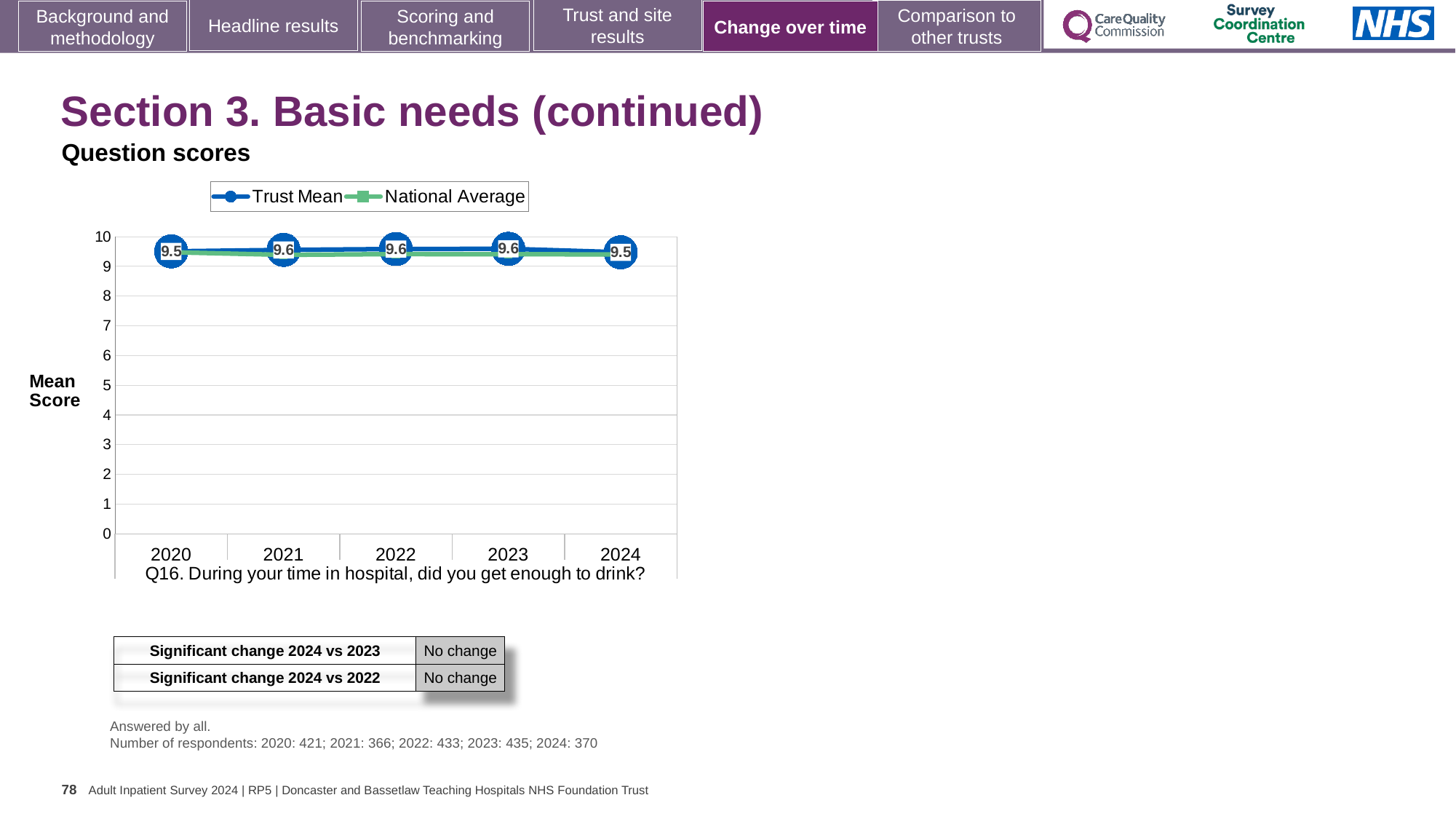
What is the difference between the Trust Mean scores for 2021 and 2020? 0.1 What is the Trust Mean score for 2023? 9.6 What is the Trust Mean score for 2024? 9.5 What are the two series named in the legend? Trust Mean and National Average How many years are plotted on the x axis? 5 What is the Trust Mean score for 2022? 9.6 What is the Trust Mean score for 2020? 9.5 Is the Trust Mean score for 2024 greater or less than 5? greater What kind of chart is shown on the slide? line chart How many series does the legend list? 2 Does the Trust Mean line rise sharply, fall sharply, or stay roughly flat from 2020 to 2024? roughly flat Which survey question does the chart show scores for? Q16. During your time in hospital, did you get enough to drink?